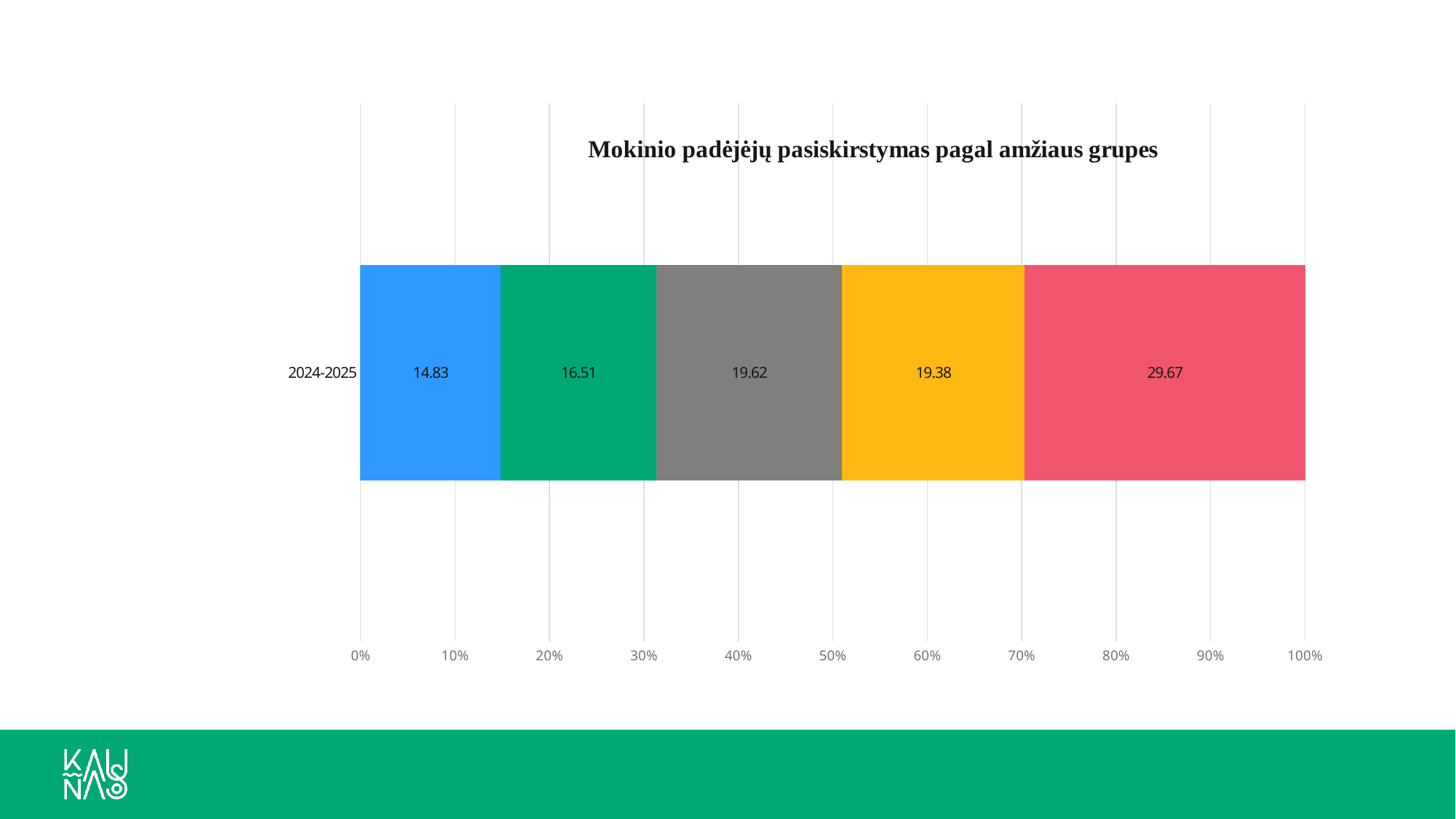
What is the title of the chart? Mokinio padėjėjų pasiskirstymas pagal amžiaus grupes What is the value of the yellow (fourth) segment of the 2024-2025 bar? 19.38 What kind of chart is shown on the slide? Stacked bar chart What is the value of the green (second) segment of the 2024-2025 bar? 16.51 What is the difference between the red segment (29.67) and the blue segment (14.83) of the 2024-2025 bar? 14.84 What is the value of the grey (third) segment of the 2024-2025 bar? 19.62 Which segment of the 2024-2025 bar has the smallest value? The blue (first) segment, 14.83 Which segment of the 2024-2025 bar has the largest value? The red (last) segment, 29.67 What is the value of the blue (first) segment of the 2024-2025 bar? 14.83 Which is larger in the 2024-2025 bar: the grey segment or the yellow segment? The grey segment (19.62) How many segments make up the 2024-2025 bar? 5 How many categories are shown on the vertical axis of the chart? 1